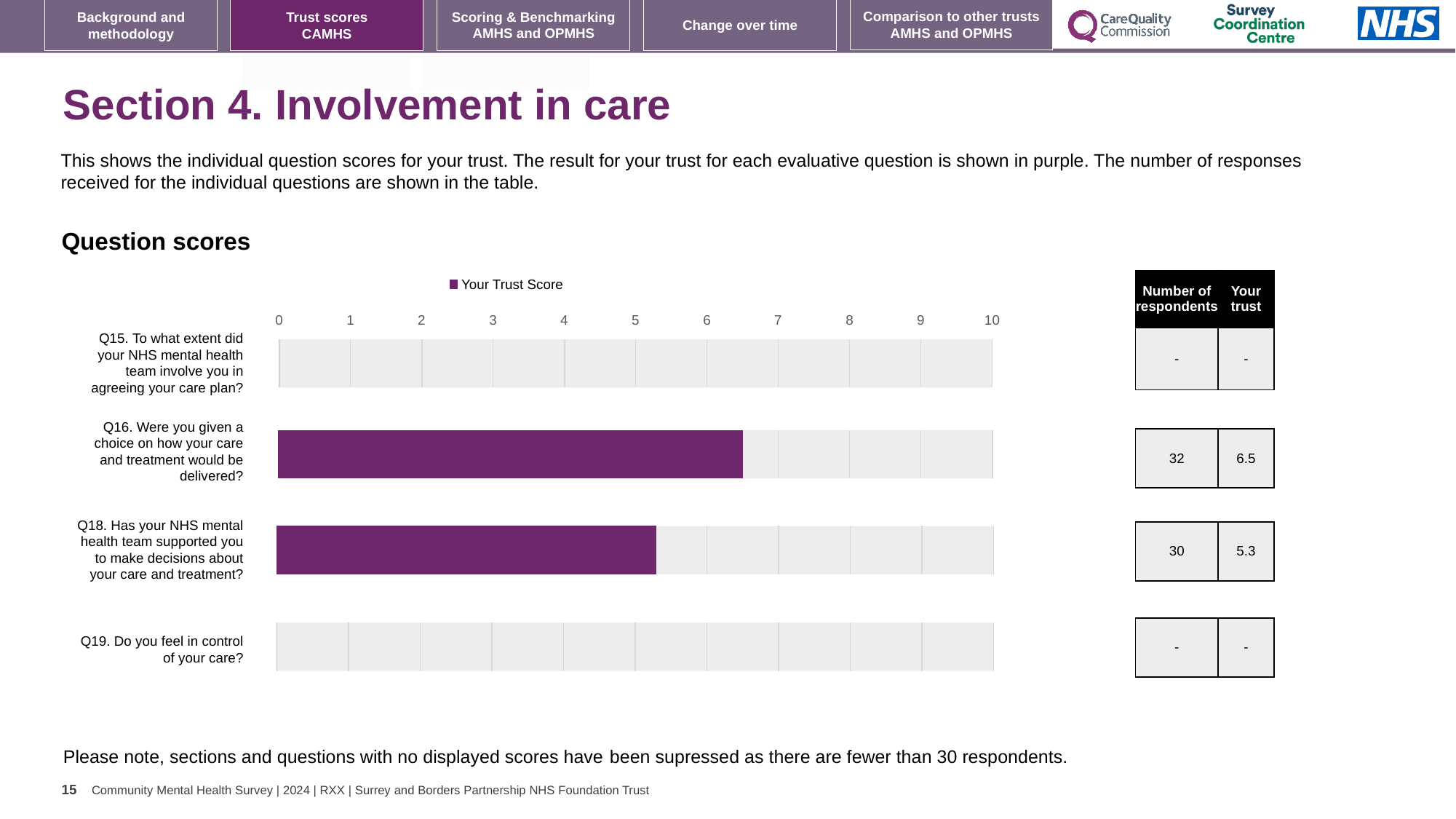
What series does the chart legend list? Your Trust Score Is the trust score for Q18 greater or less than 6? less How many respondents answered Q16? 32 What type of chart is shown under 'Question scores'? Bar chart How many respondents answered Q18? 30 Which question has the lowest displayed trust score? Q18 What is the difference between the trust scores for Q16 and Q18? 1.2 How many questions are listed on the chart? 4 Which question has the highest displayed trust score? Q16 What is the trust score for Q16 (Were you given a choice on how your care and treatment would be delivered?)? 6.5 Which has the larger trust score, Q16 or Q18? Q16 What is the trust score for Q18 (Has your NHS mental health team supported you to make decisions about your care and treatment?)? 5.3